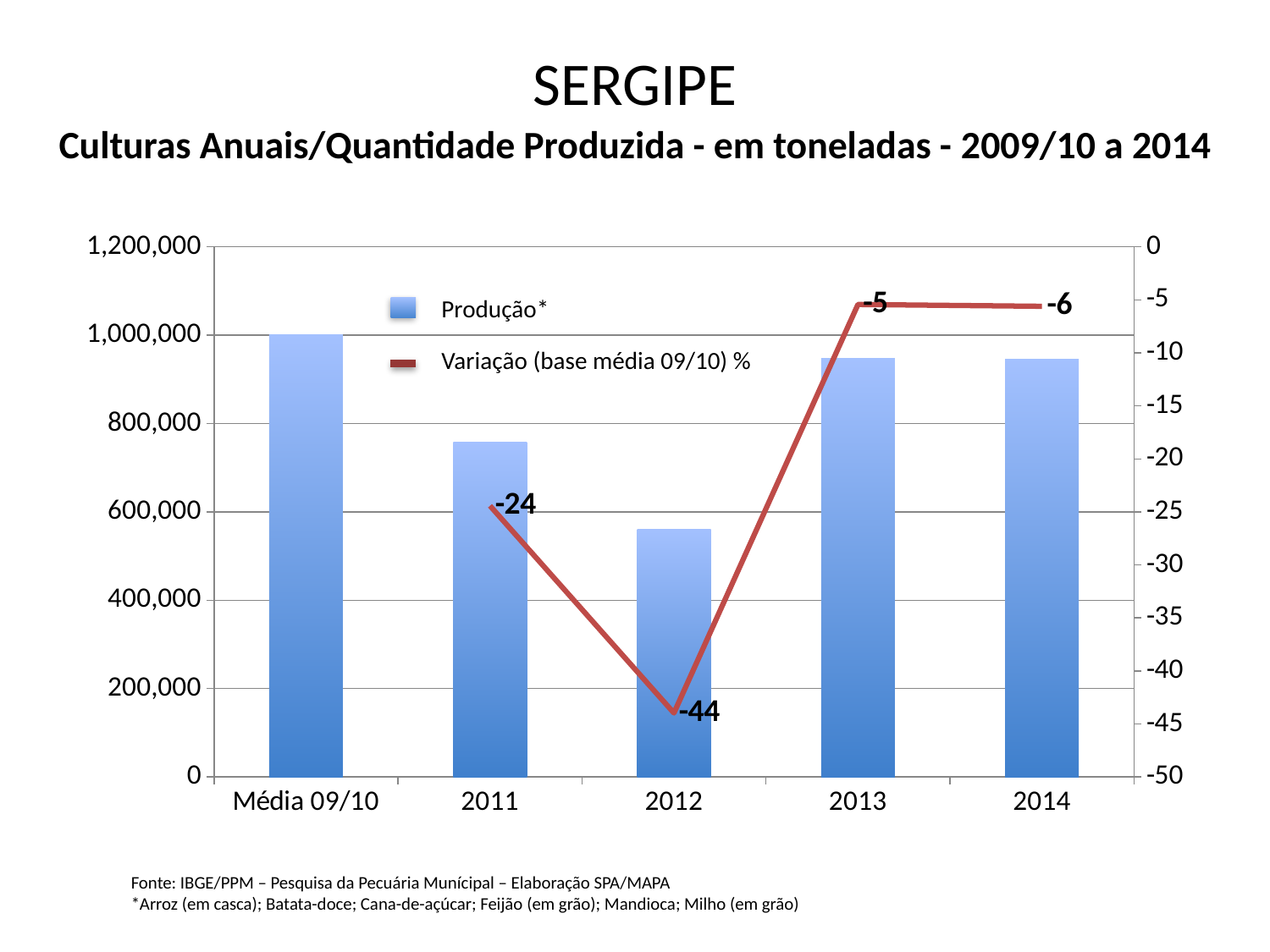
What is the value of Variação (base média 09/10) % for 2014? -6 How many categories are shown on the x axis? 5 Is the Produção value for 2011 greater or less than 600,000? greater What is the value of Variação (base média 09/10) % for 2012? -44 In which year is the Variação (base média 09/10) % lowest? 2012 Which category has the highest Produção bar? Média 09/10 Which category has the lowest Produção bar? 2012 Is the Produção value for 2012 greater or less than 600,000? less How many series does the legend list? 2 What is the value of Variação (base média 09/10) % for 2013? -5 What is the value of Variação (base média 09/10) % for 2011? -24 What is the difference between the Variação values for 2011 and 2012? 20